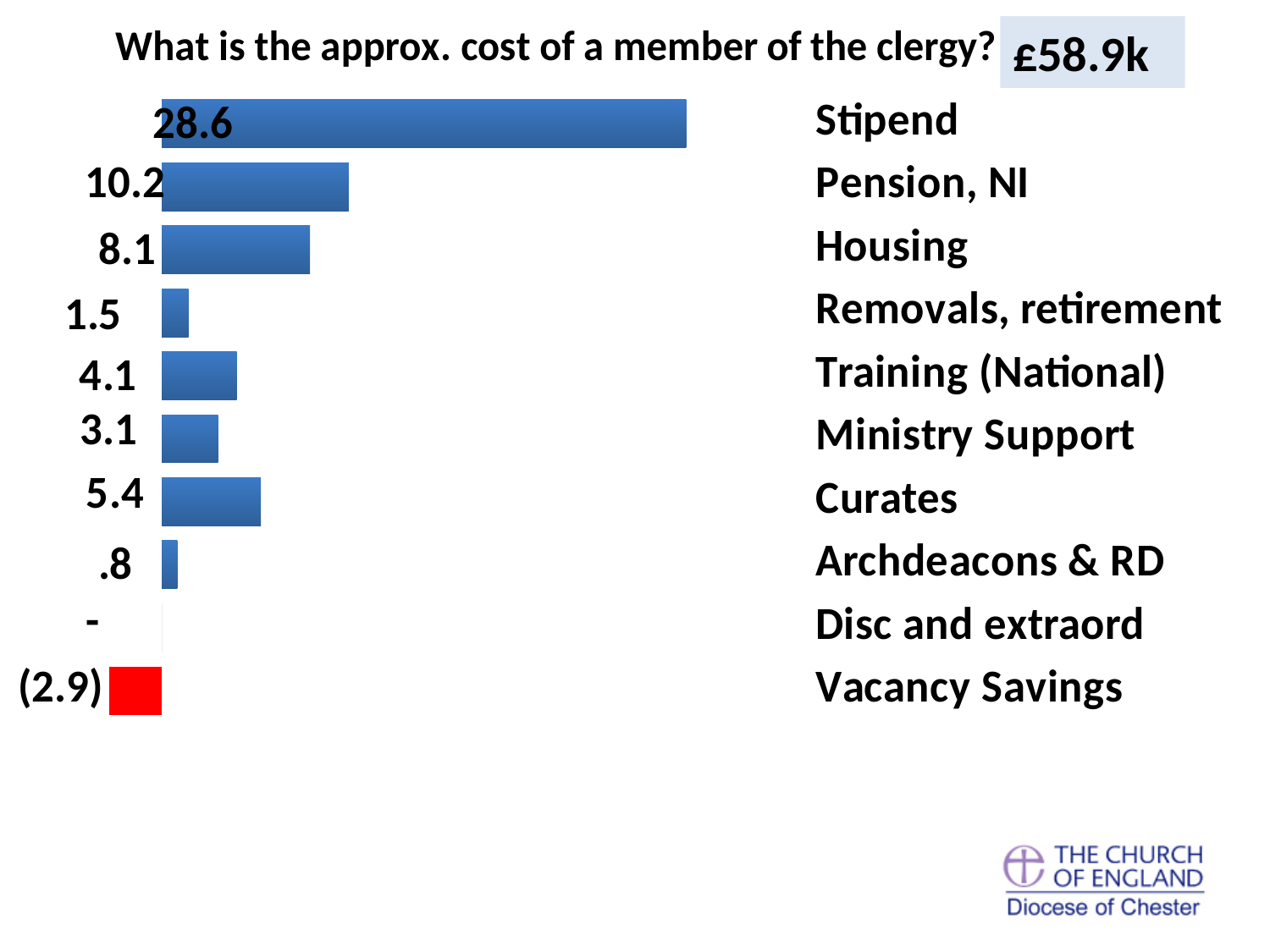
What is the difference between the values for Stipend and Pension, NI? 18.4 What kind of chart is shown on the slide? Bar chart What is the value shown for Stipend? 28.6 What is the value shown for Archdeacons & RD? .8 Which is larger, the value for Curates or the value for Training (National)? Curates Which category is shown with a negative value in a red bar? Vacancy Savings Which category has the highest value? Stipend What is the value shown for Housing? 8.1 What is the value shown for Vacancy Savings? (2.9) What approximate total cost of a member of the clergy is shown at the top of the slide? £58.9k What is the value shown for Pension, NI? 10.2 How many categories are listed in the chart? 10